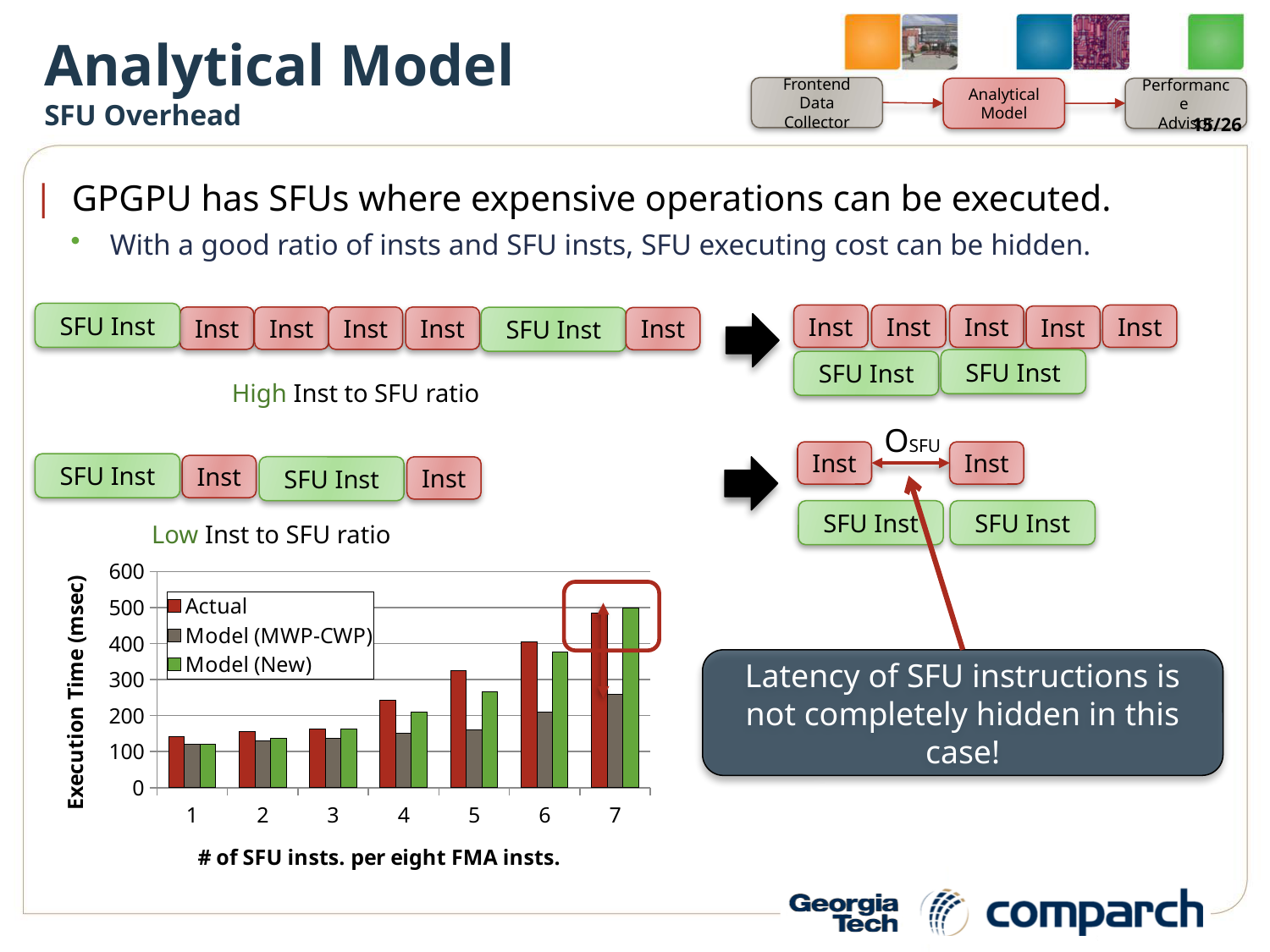
Is the Actual value at 5 SFU insts. per eight FMA insts. greater or less than 300? greater Is the Model (MWP-CWP) value at 7 SFU insts. per eight FMA insts. greater or less than 300? less How many categories are shown along the x axis of the chart? 7 At 5 SFU insts. per eight FMA insts., which is larger: Actual or Model (MWP-CWP)? Actual At 6 SFU insts. per eight FMA insts., which is larger: Model (New) or Model (MWP-CWP)? Model (New) At which number of SFU insts. per eight FMA insts. is the Actual execution time highest? 7 Is the Actual value at 7 SFU insts. per eight FMA insts. greater or less than 400? greater What kind of chart is shown on the slide? bar chart Does the Actual execution time rise or fall as the number of SFU insts. per eight FMA insts. increases from 1 to 7? rise What is the title of the chart's y axis? Execution Time (msec) How many series does the chart's legend list? 3